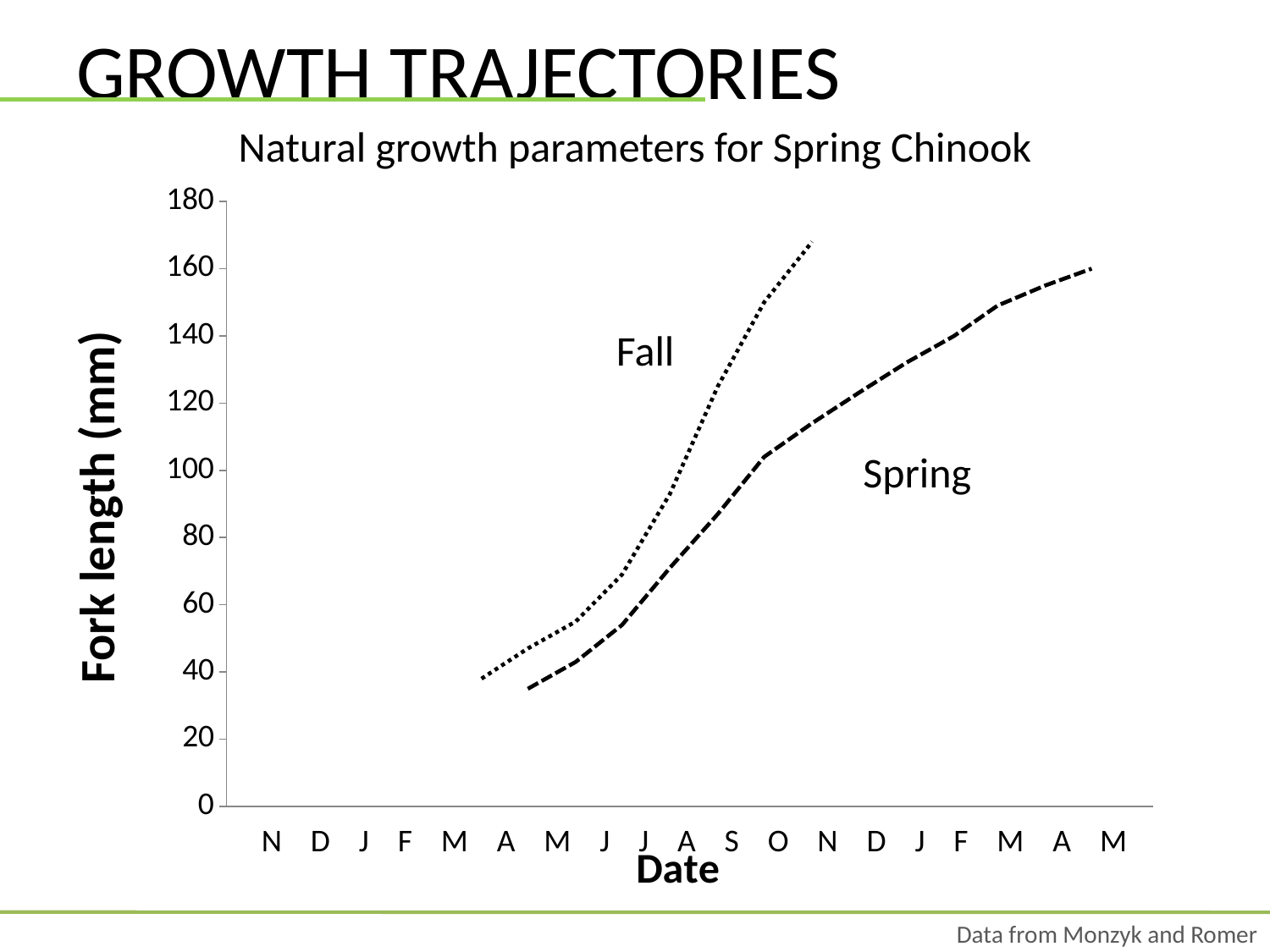
Is the value of the Fall line in September greater or less than 120? greater Which line reaches the higher maximum fork length, Fall or Spring? Fall Does the Spring line rise or fall as the date advances along the x axis? rise What is the label of the y axis? Fork length (mm) Is the starting value of the Spring line greater or less than 40? less What is the title of the chart? Natural growth parameters for Spring Chinook Does the Fall line rise or fall as the date advances along the x axis? rise In September, which line shows the larger fork length, Fall or Spring? Fall What kind of chart is shown on the slide? line chart Is the highest value of the Fall line greater or less than 160? greater How many month labels are shown along the x axis? 19 How many lines (series) are plotted on the chart? 2